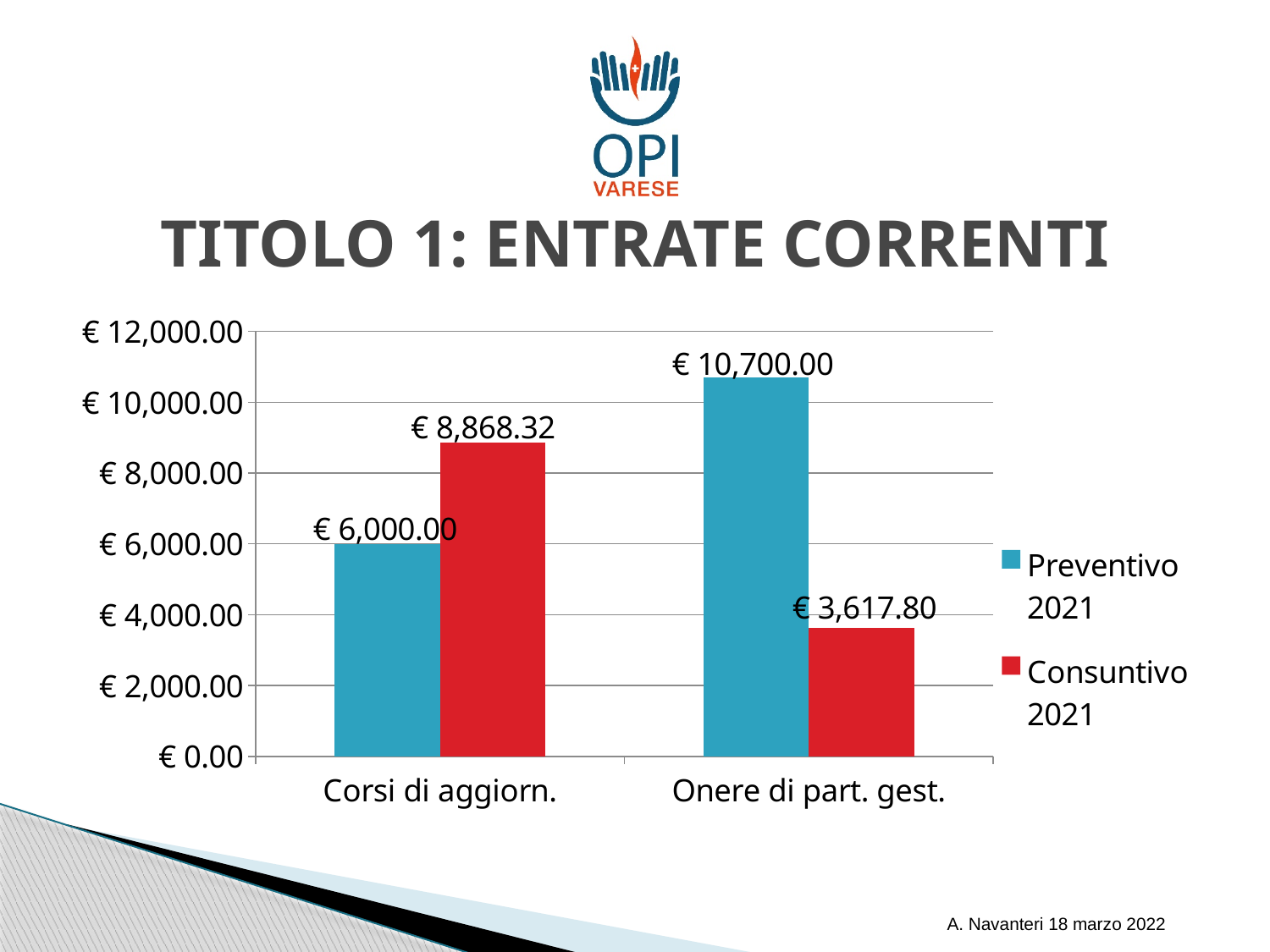
Is the Consuntivo 2021 value for Onere di part. gest. greater or less than € 4,000.00? less What is the Consuntivo 2021 value for Corsi di aggiorn.? € 8,868.32 What is the Preventivo 2021 value for Corsi di aggiorn.? € 6,000.00 How many series does the legend list? 2 How many categories are shown on the x axis? 2 Which category has the highest Preventivo 2021 value? Onere di part. gest. What is the Preventivo 2021 value for Onere di part. gest.? € 10,700.00 For Corsi di aggiorn., which is larger: Preventivo 2021 or Consuntivo 2021? Consuntivo 2021 What is the difference between the Preventivo 2021 and Consuntivo 2021 values for Onere di part. gest.? € 7,082.20 What kind of chart is shown on the slide? bar chart What is the Consuntivo 2021 value for Onere di part. gest.? € 3,617.80 Which category has the lowest Consuntivo 2021 value? Onere di part. gest.